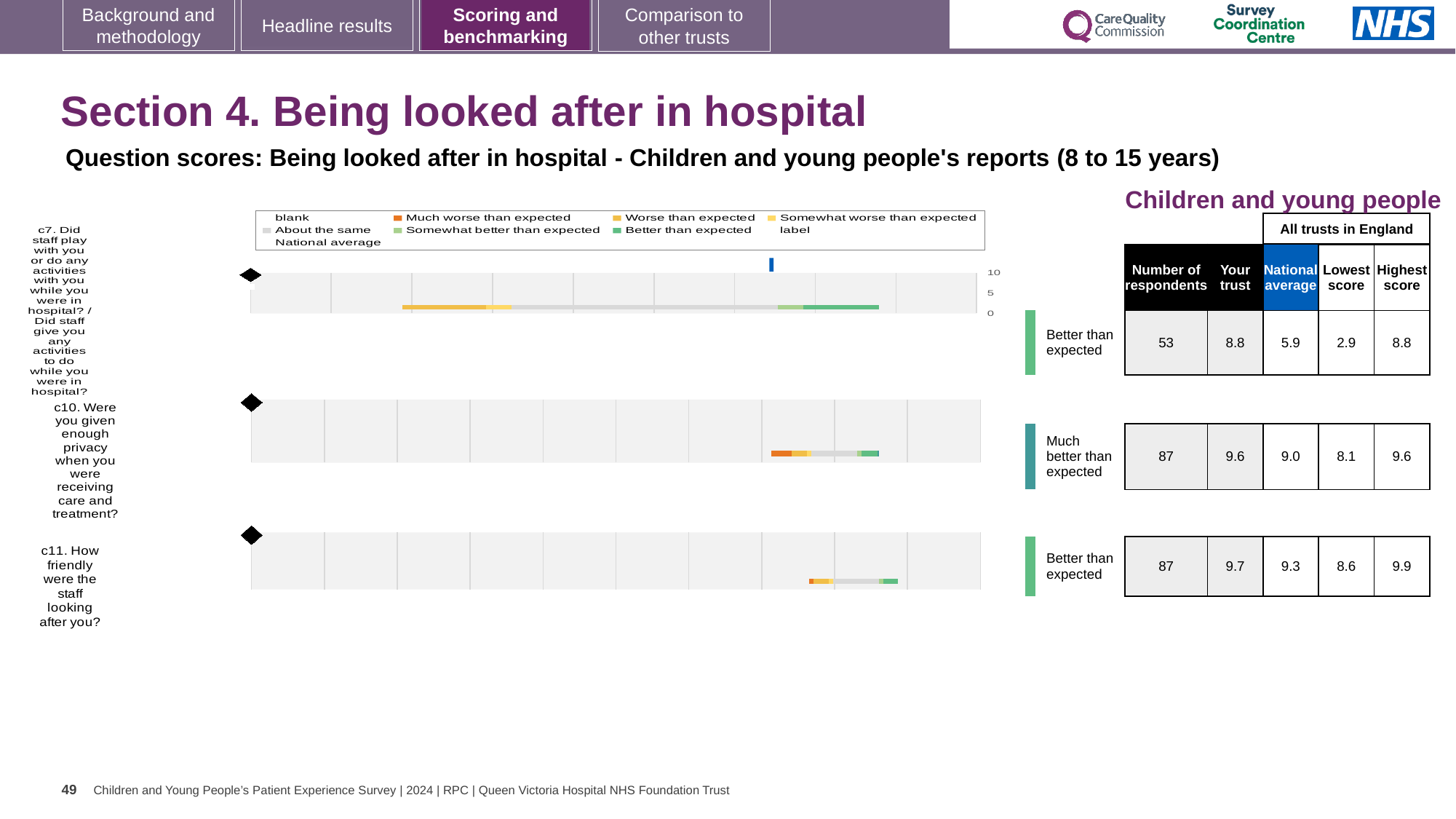
How many survey questions are plotted in the chart? 3 Which is larger: the national average for c7 or the national average for c10? c10 What is the 'Your trust' score for c10 (Were you given enough privacy when you were receiving care and treatment?)? 9.6 What kind of chart is used to show the question scores on this slide? bar chart By how much does the trust's score for c7 exceed the national average for c7? 2.9 What benchmark category is shown for c10 (Were you given enough privacy when you were receiving care and treatment?)? Much better than expected How many respondents answered question c7? 53 What is the lowest score across all trusts in England for c11 (How friendly were the staff looking after you?)? 8.6 What is the national average score for c7 (Did staff play with you or do any activities with you while you were in hospital?)? 5.9 What is the highest score across all trusts in England for c10? 9.6 Which question has the highest 'Your trust' score? c11. How friendly were the staff looking after you? Which question has the lowest 'Your trust' score? c7. Did staff play with you or do any activities with you while you were in hospital?